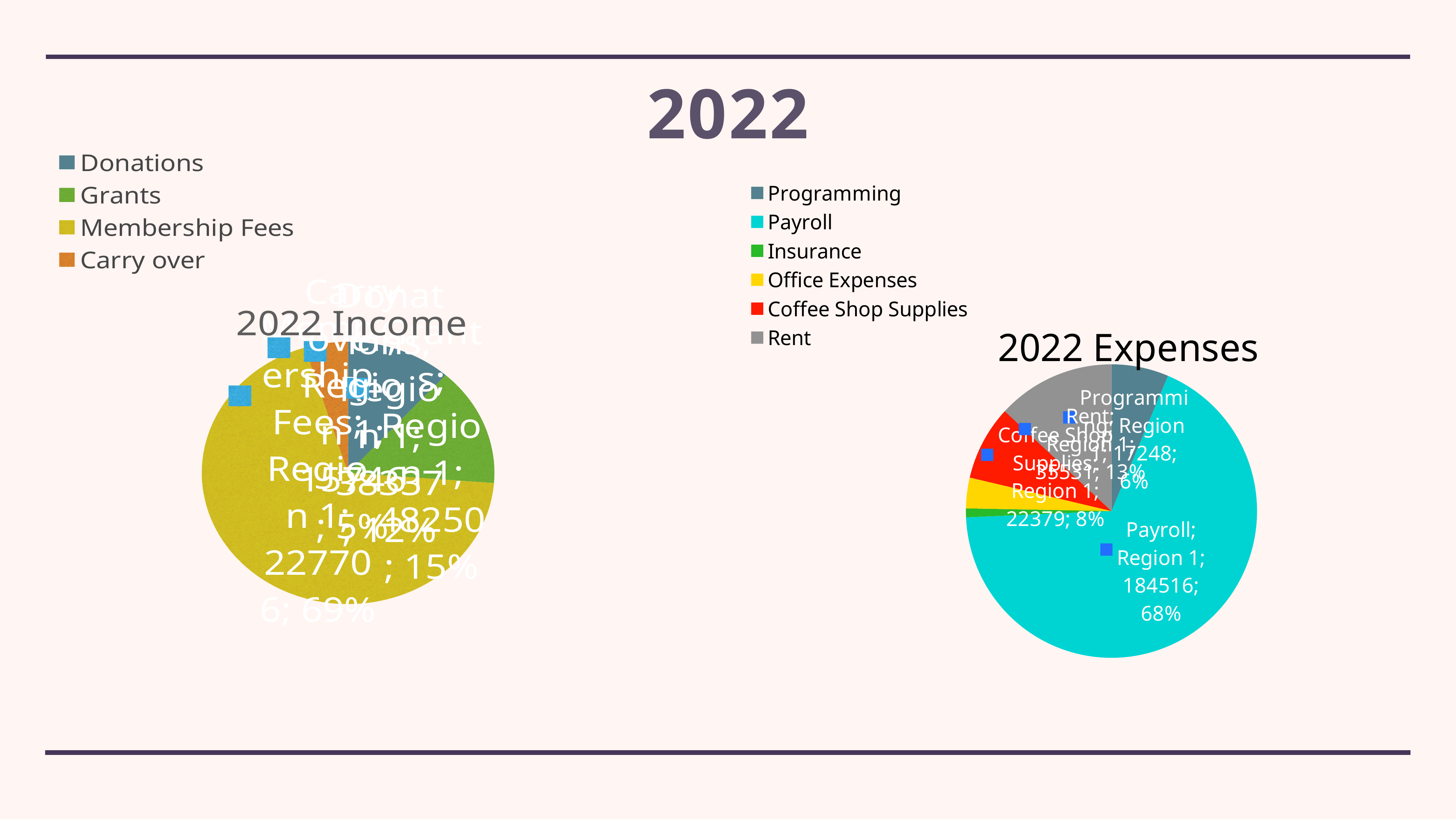
In the 2022 Expenses chart, which category has the largest slice? Payroll What kind of chart is the 2022 Expenses chart? pie chart In the 2022 Expenses chart, what is the difference between the Payroll value and the Rent value? 148985 In the 2022 Expenses chart, what share of the pie is Rent? 13% In the 2022 Expenses chart, what share of the pie is Payroll? 68% In the 2022 Expenses chart, which category has the smallest slice? Insurance How many categories does the legend of the 2022 Expenses chart list? 6 In the 2022 Expenses chart, what is the value for Coffee Shop Supplies? 22379 In the 2022 Income chart, which category has the largest slice? Membership Fees In the 2022 Expenses chart, what is the value for Payroll? 184516 How many categories does the legend of the 2022 Income chart list? 4 In the 2022 Expenses chart, which is larger, Rent or Coffee Shop Supplies? Rent